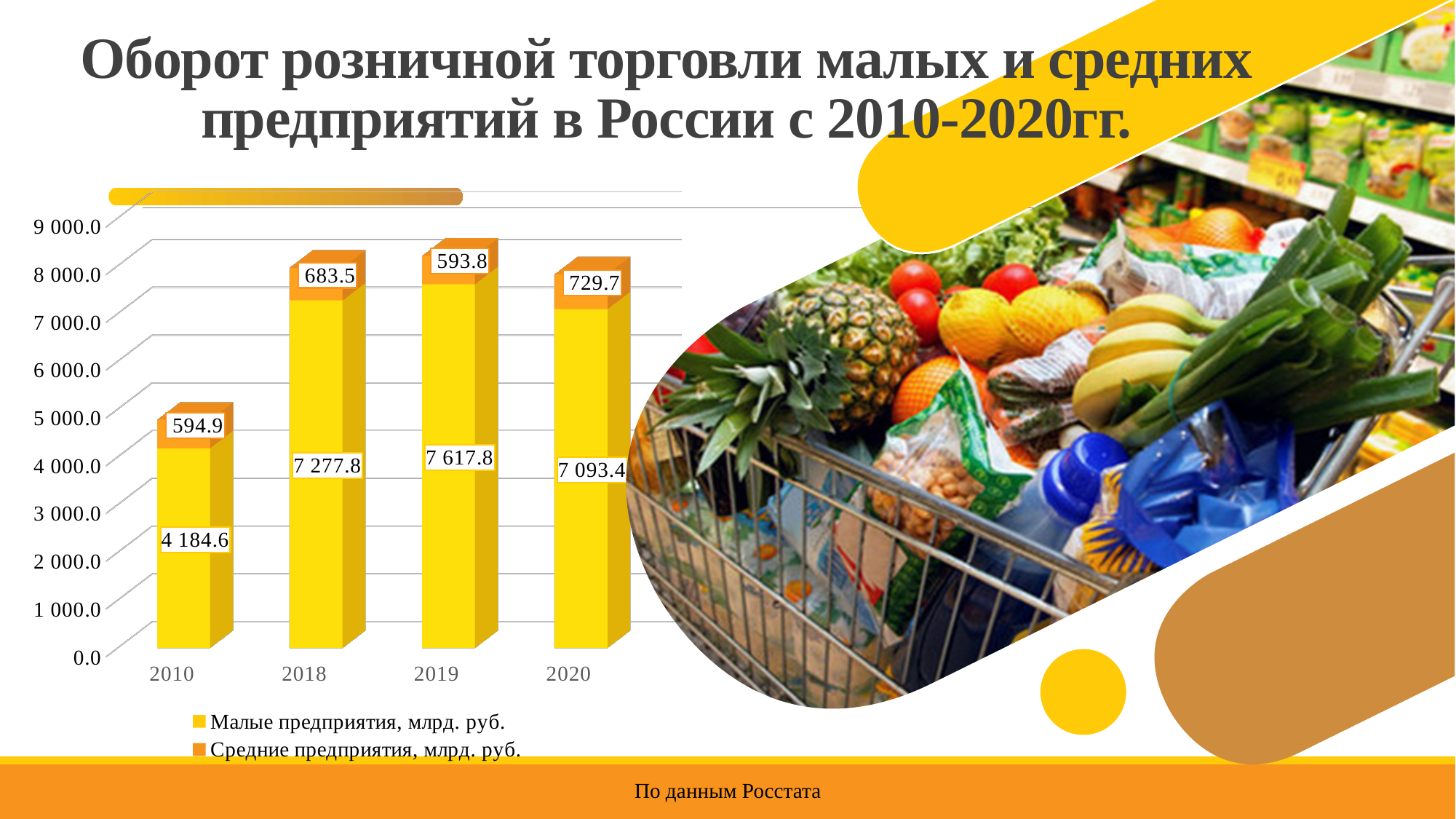
What is the value for Средние предприятия in 2020? 729.7 What is the value for Малые предприятия in 2019? 7 617.8 What is the total of the stacked bar for 2018? 7 961.3 What kind of chart is shown on the slide? Stacked bar chart Which is larger: the Средние предприятия value for 2018 or for 2020? 2020 Which year has the lowest value for Средние предприятия? 2019 How many series does the legend list? 2 What is the value for Малые предприятия in 2010? 4 184.6 Which year has the highest value for Малые предприятия? 2019 How many years are shown on the x axis? 4 Is the total of the stacked bar for 2010 greater or less than 5 000.0? less What is the difference between the Малые предприятия values for 2019 and 2018? 340.0